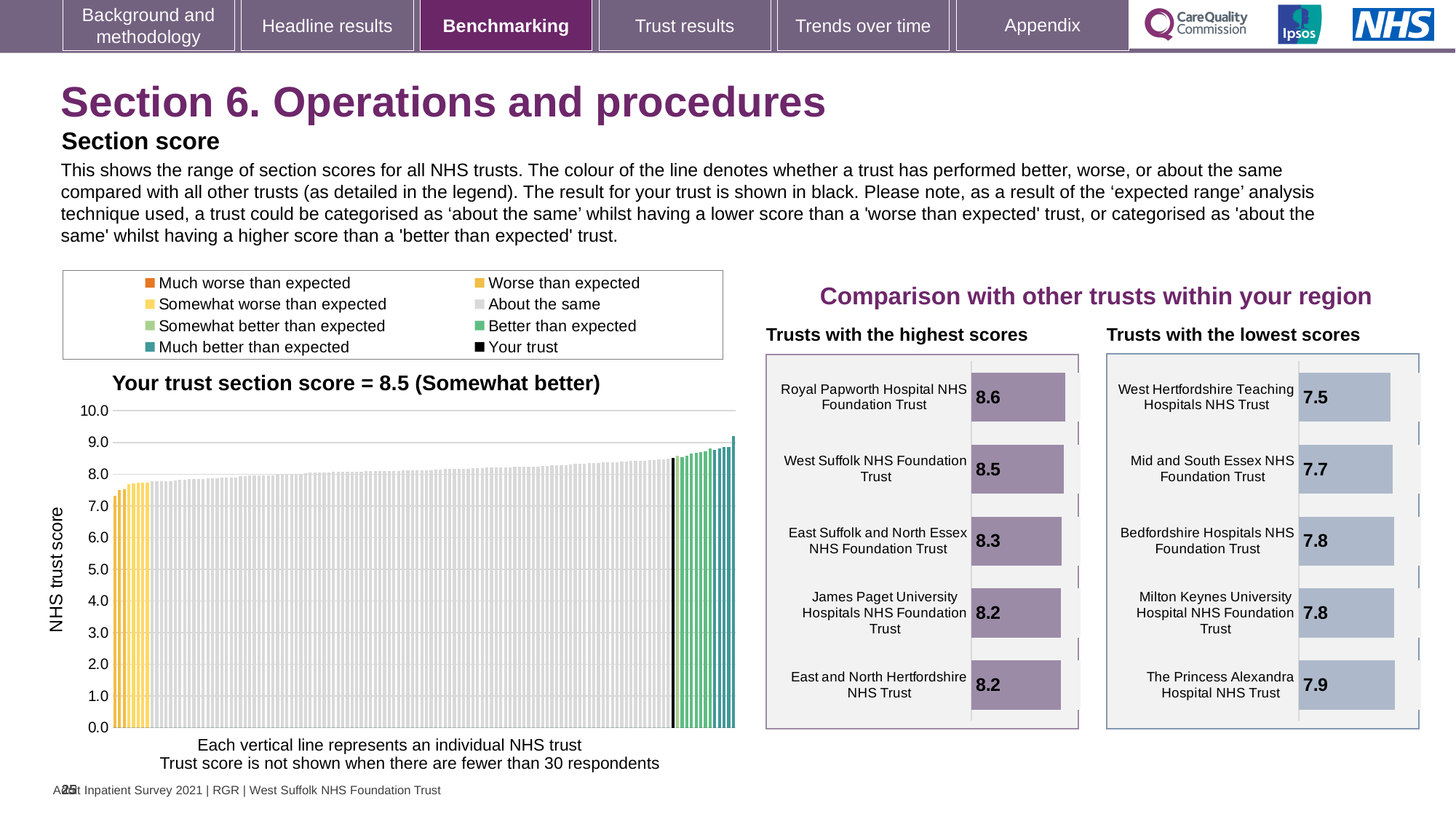
In the 'Your trust section score' chart, do the bars rise or fall from left to right? Rise In the 'Trusts with the highest scores' chart, what is the score for Royal Papworth Hospital NHS Foundation Trust? 8.6 In the 'Trusts with the highest scores' chart, what is the difference between the scores of Royal Papworth Hospital NHS Foundation Trust and East and North Hertfordshire NHS Trust? 0.4 In the 'Your trust section score' chart, what is the label on the vertical axis? NHS trust score In the 'Trusts with the lowest scores' chart, what is the score for The Princess Alexandra Hospital NHS Trust? 7.9 In the 'Trusts with the lowest scores' chart, which has the higher score: Mid and South Essex NHS Foundation Trust or Bedfordshire Hospitals NHS Foundation Trust? Bedfordshire Hospitals NHS Foundation Trust In the 'Your trust section score' chart, is the value of the leftmost (lowest) bar greater or less than 8.0? less In the 'Trusts with the lowest scores' chart, which trust has the lowest score? West Hertfordshire Teaching Hospitals NHS Trust In the 'Trusts with the highest scores' chart, how many trusts are shown? 5 In the 'Your trust section score' chart, what is the section score for your trust as stated in the chart title? 8.5 In the 'Your trust section score' chart, what kind of chart is shown? Bar chart In the 'Your trust section score' chart, how many entries does the legend list? 8